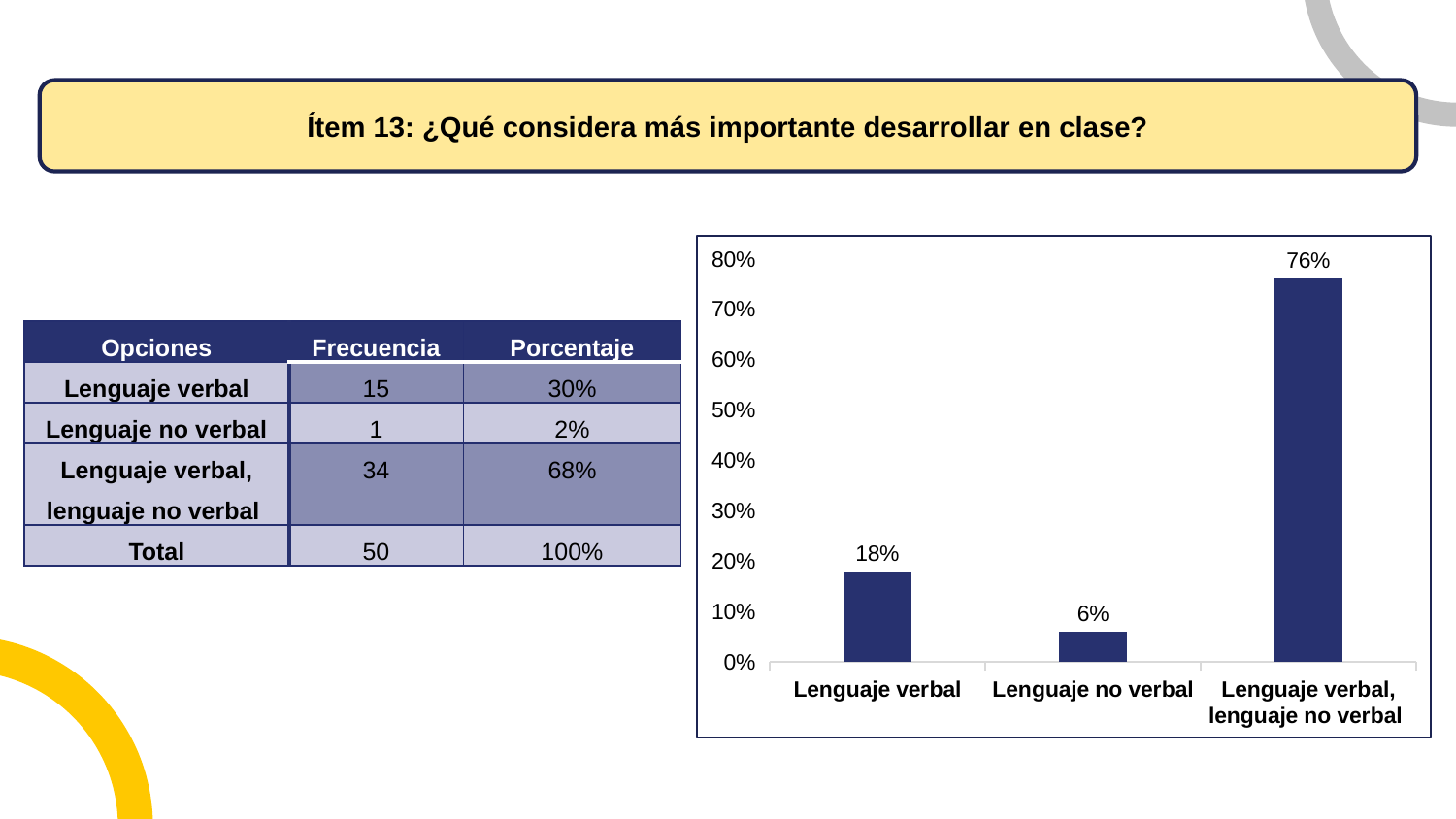
How many categories are shown in the chart? 3 What kind of chart is shown on the slide? Bar chart What value does the chart show for Lenguaje verbal? 18% What is the difference between the chart values for Lenguaje verbal, lenguaje no verbal and Lenguaje verbal? 58% What is the highest value shown on the chart's vertical axis? 80% What value does the chart show for Lenguaje verbal, lenguaje no verbal? 76% Is the chart value for Lenguaje verbal, lenguaje no verbal greater or less than 70%? greater What is the difference between the chart values for Lenguaje verbal and Lenguaje no verbal? 12% What value does the chart show for Lenguaje no verbal? 6% Which category has the lowest value in the chart? Lenguaje no verbal Which category has the highest value in the chart? Lenguaje verbal, lenguaje no verbal Which is larger in the chart, Lenguaje verbal or Lenguaje no verbal? Lenguaje verbal